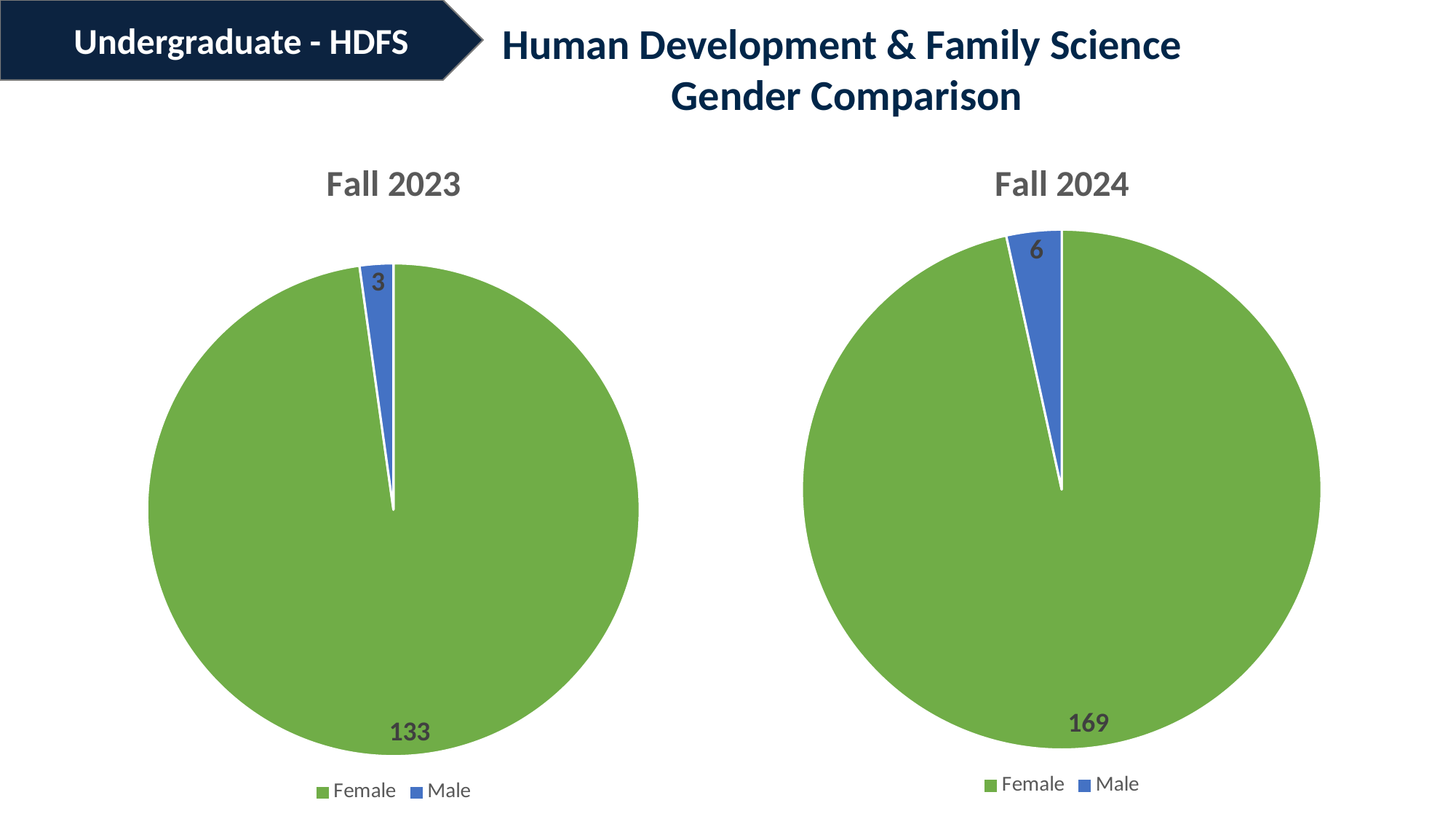
In the Fall 2023 chart, which category has the smallest slice? Male How many slices does the Fall 2023 chart have? 2 In the Fall 2023 chart, what is the value for Male? 3 In the Fall 2023 chart, what is the value for Female? 133 What kind of chart is the Fall 2024 chart? pie chart In the Fall 2024 chart, which category has the largest slice? Female In the Fall 2024 chart, what is the value for Female? 169 In the Fall 2024 chart, what is the value for Male? 6 In the Fall 2024 chart, what is the difference between the Female and Male values? 163 In the Fall 2023 chart, what colour is the Male slice? blue In the Fall 2023 chart, what is the difference between the Female and Male values? 130 Is the Female value in the Fall 2024 chart larger or smaller than the Female value in the Fall 2023 chart? larger